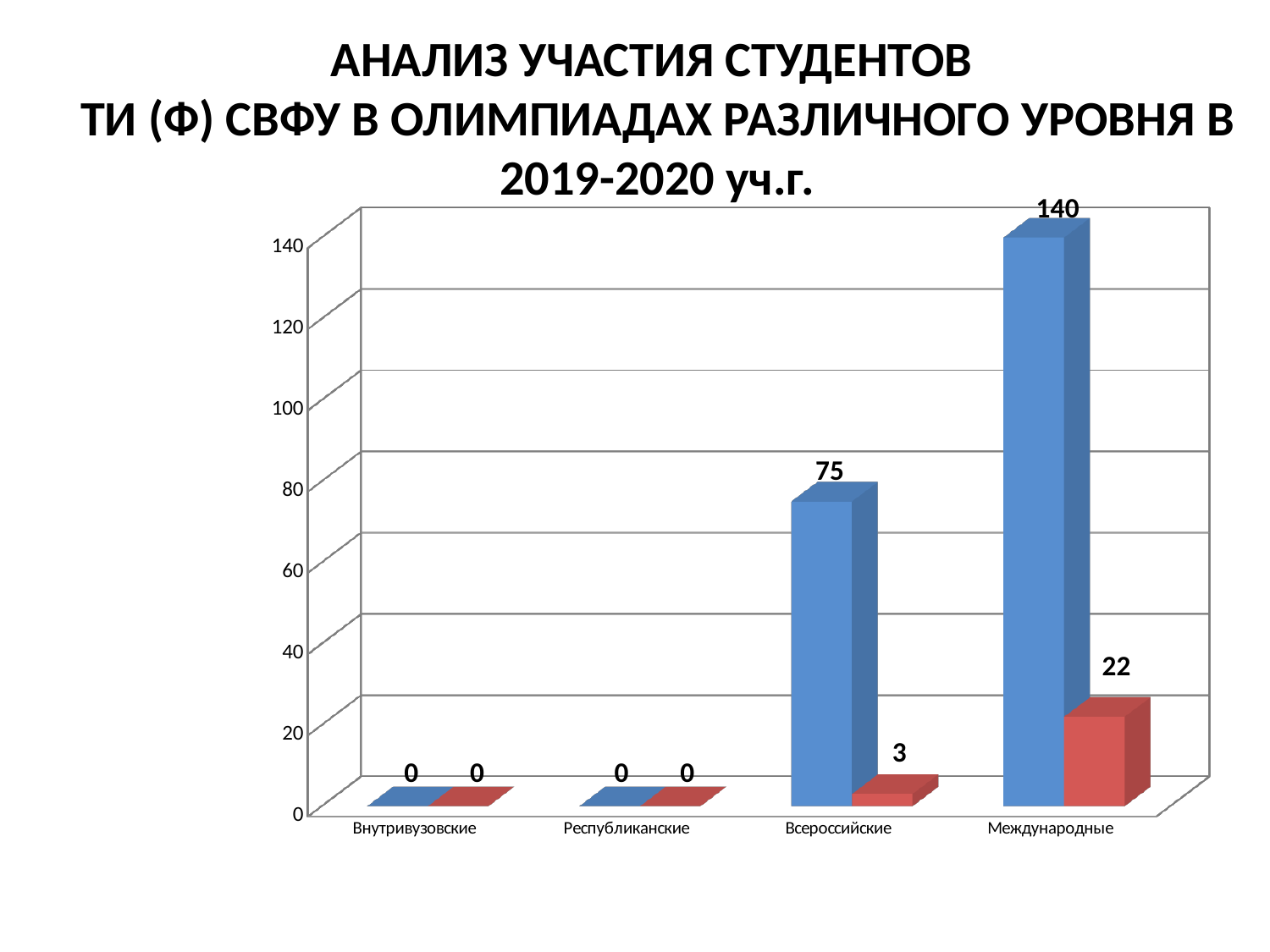
What is the difference between the blue bars for Международные and Всероссийские? 65 What is the highest value shown on the vertical axis? 140 What is the value of the blue bar for Международные? 140 What is the value of the blue bar for Всероссийские? 75 What is the difference between the blue and red bars for Международные? 118 How many categories are shown on the x axis? 4 What kind of chart is shown on the slide? bar chart What is the value of the blue bar for Республиканские? 0 What is the value of the red bar for Всероссийские? 3 Which is larger for Всероссийские, the blue bar or the red bar? the blue bar Which category has the highest blue bar? Международные What is the value of the red bar for Международные? 22